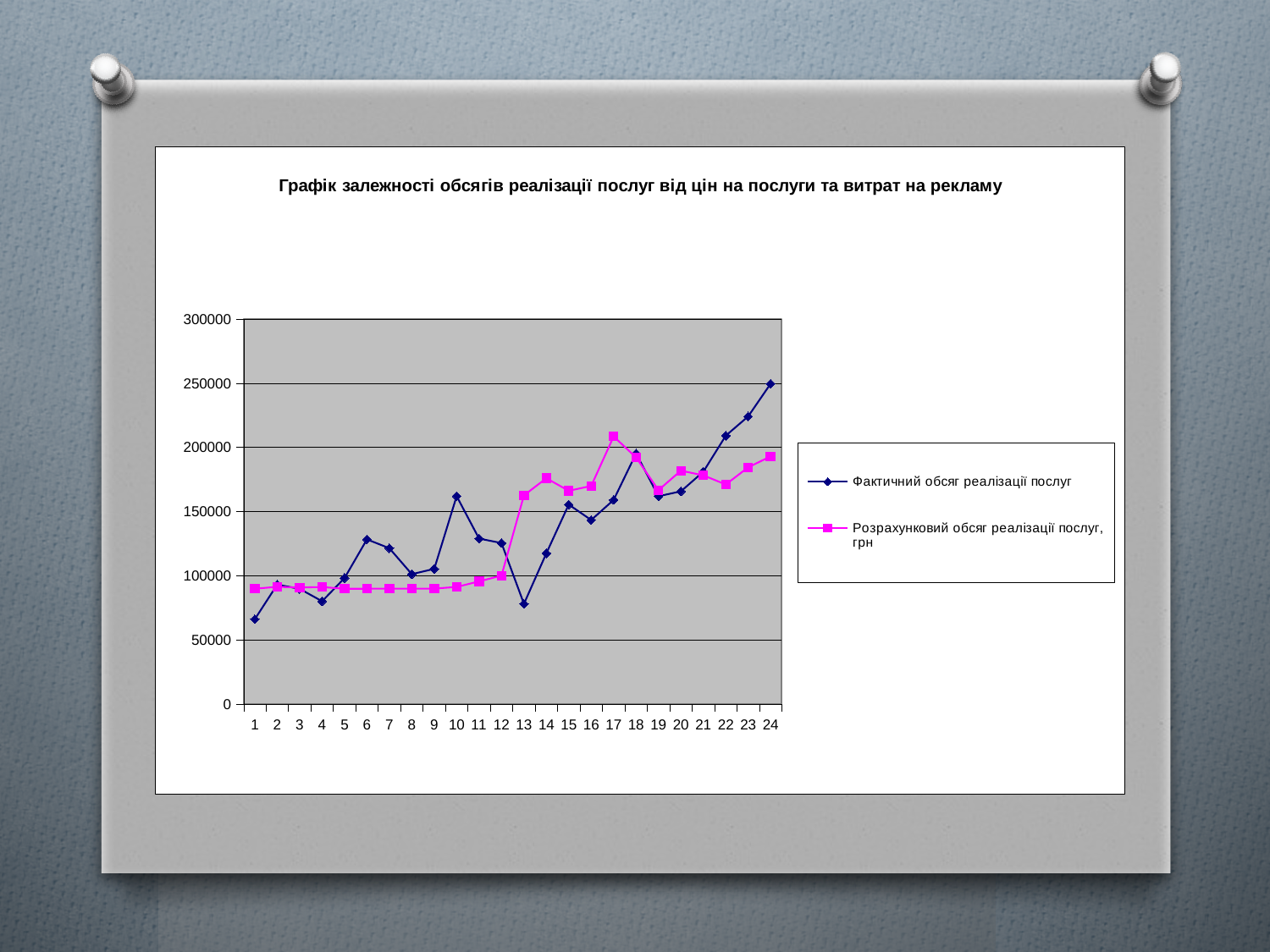
Overall, do the values of 'Фактичний обсяг реалізації послуг' rise or fall from point 1 to point 24? rise Is the value of 'Розрахунковий обсяг реалізації послуг, грн' at point 1 greater or less than 100000? less Is the value of 'Фактичний обсяг реалізації послуг' at point 10 greater or less than 150000? greater At which x-axis point does the series 'Фактичний обсяг реалізації послуг' reach its highest value? 24 What kind of chart is shown on the slide? line chart Is the value of 'Фактичний обсяг реалізації послуг' at point 24 greater or less than 200000? greater At point 13, which series has the higher value: 'Фактичний обсяг реалізації послуг' or 'Розрахунковий обсяг реалізації послуг, грн'? Розрахунковий обсяг реалізації послуг, грн How many points are plotted along the x axis for each series? 24 Which series is drawn in pink with square markers? Розрахунковий обсяг реалізації послуг, грн How many series does the legend list? 2 What is the title of the chart? Графік залежності обсягів реалізації послуг від цін на послуги та витрат на рекламу